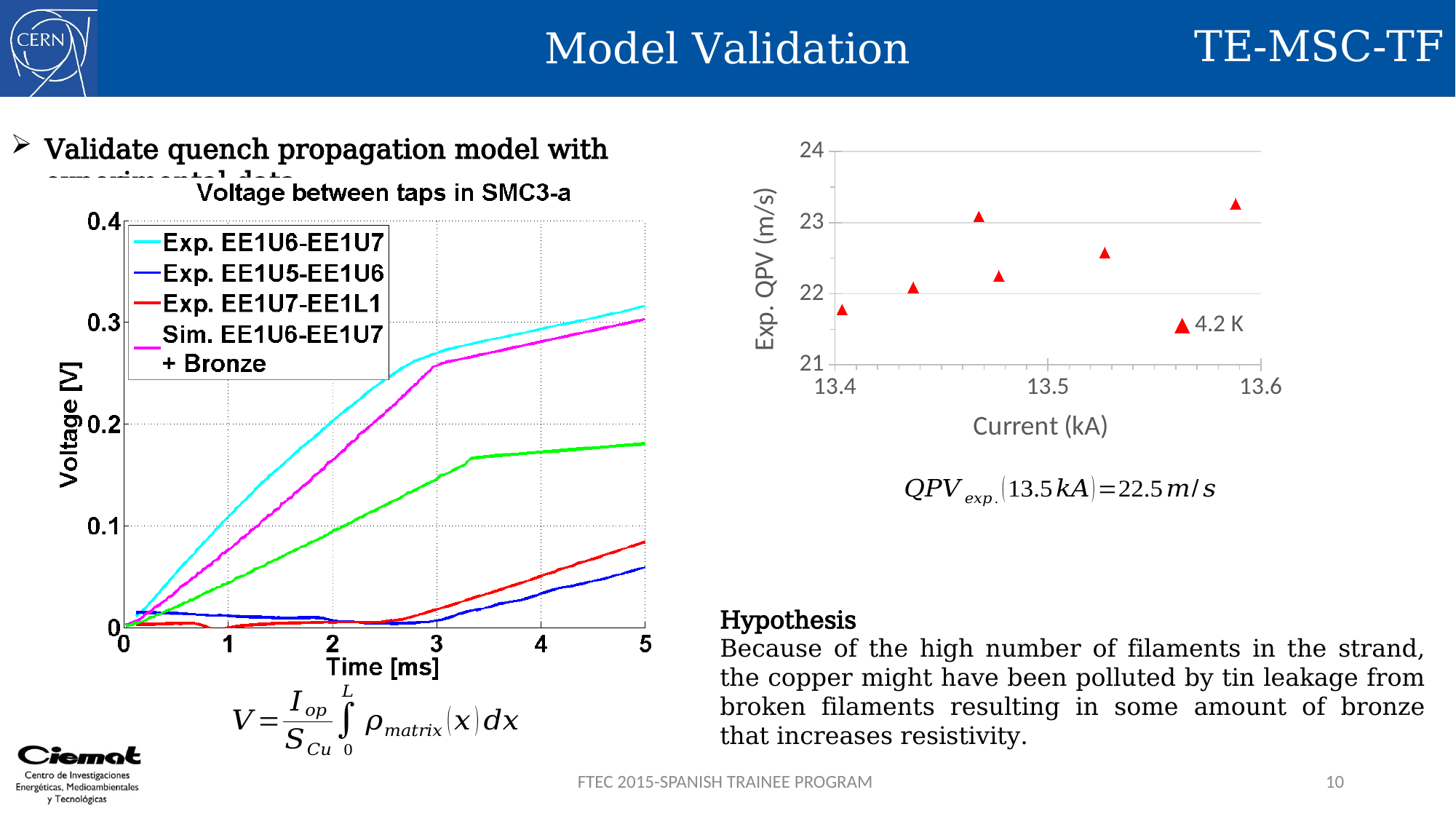
In the 'Voltage between taps in SMC3-a' chart, does the Exp. EE1U6-EE1U7 voltage rise or fall as time increases? rise In the Exp. QPV vs Current chart on the right, does Exp. QPV generally rise or fall as current increases? rise What is the x-axis label of the 'Voltage between taps in SMC3-a' chart? Time [ms] In the 'Voltage between taps in SMC3-a' chart, is the Exp. EE1U6-EE1U7 voltage at 4 ms greater or less than 0.2 V? greater In the 'Voltage between taps in SMC3-a' chart, which is larger at 5 ms: the Exp. EE1U7-EE1L1 voltage or the Exp. EE1U5-EE1U6 voltage? Exp. EE1U7-EE1L1 In the Exp. QPV vs Current chart on the right, is the Exp. QPV value at 13.4 kA greater or less than 22 m/s? less How many series does the legend of the 'Voltage between taps in SMC3-a' chart list? 4 What kind of chart is the chart on the right of the slide, plotting Exp. QPV against Current? scatter chart In the 'Voltage between taps in SMC3-a' chart, is the Exp. EE1U7-EE1L1 voltage at 5 ms greater or less than 0.1 V? less What kind of chart is the 'Voltage between taps in SMC3-a' chart? line chart What is the title of the chart on the left of the slide? Voltage between taps in SMC3-a How many data points are plotted in the Exp. QPV vs Current chart on the right? 6